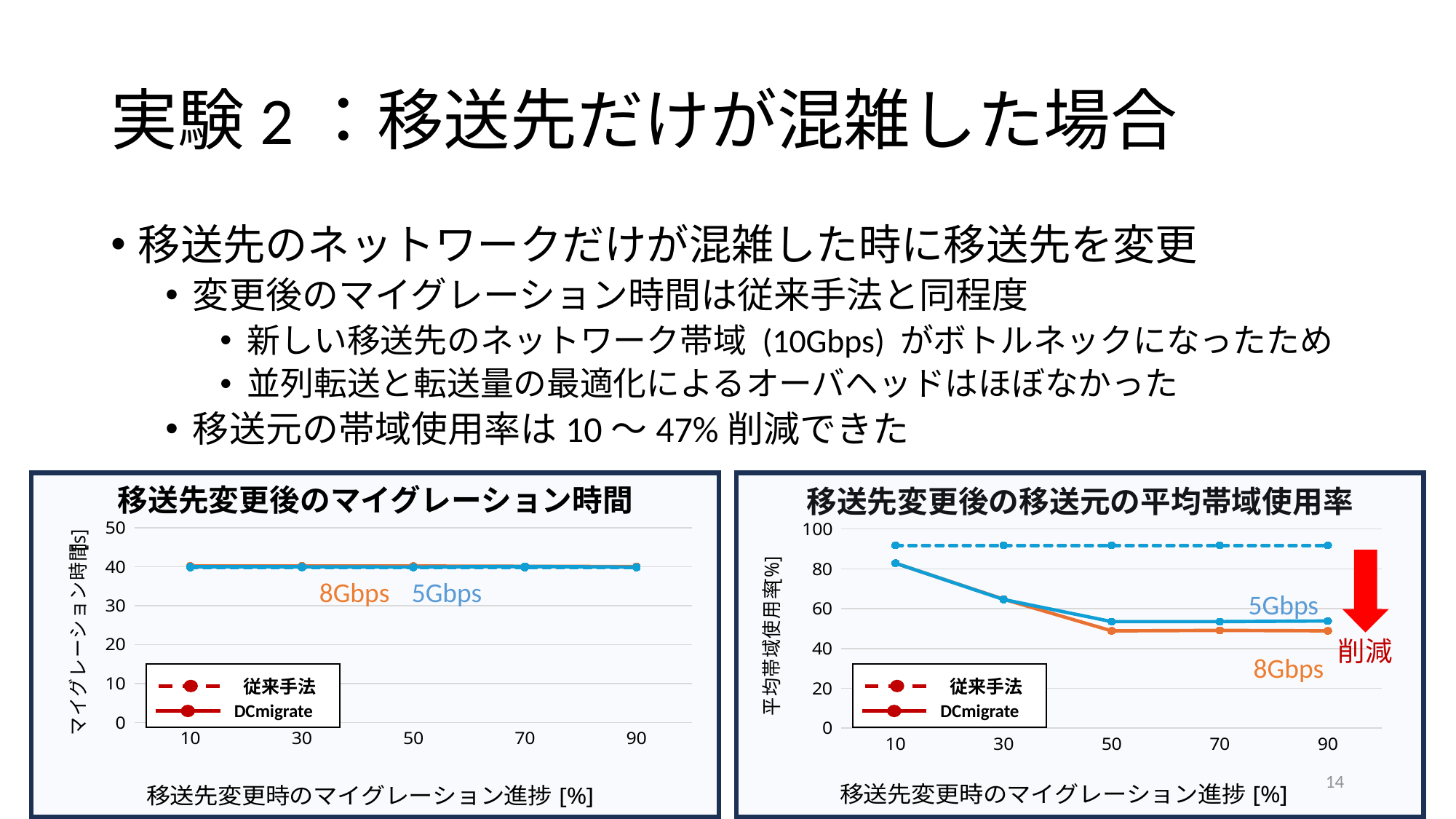
In the left chart (移送先変更後のマイグレーション時間), is the migration time at 90% progress greater or less than 50? less What kind of chart is the left chart titled 移送先変更後のマイグレーション時間? line chart In the right chart (移送先変更後の移送元の平均帯域使用率), is the 5Gbps solid line value at 10% progress greater or less than 60? greater In the left chart (移送先変更後のマイグレーション時間), do the migration time lines rise, fall, or stay flat as progress increases from 10 to 90? stay flat In the right chart (移送先変更後の移送元の平均帯域使用率), at 90% progress, which is higher: the dashed 従来手法 line or the solid DCmigrate lines? 従来手法 In the right chart (移送先変更後の移送元の平均帯域使用率), is the 8Gbps solid line value at 90% progress greater or less than 60? less In the left chart (移送先変更後のマイグレーション時間), how many entries does the legend list? 2 What is the x-axis label of the right chart (移送先変更後の移送元の平均帯域使用率)? 移送先変更時のマイグレーション進捗 [%] What kind of chart is the right chart titled 移送先変更後の移送元の平均帯域使用率? line chart In the right chart (移送先変更後の移送元の平均帯域使用率), do the solid DCmigrate lines rise or fall from 10% to 50% progress? fall In the left chart (移送先変更後のマイグレーション時間), how many x-axis points are plotted for each line? 5